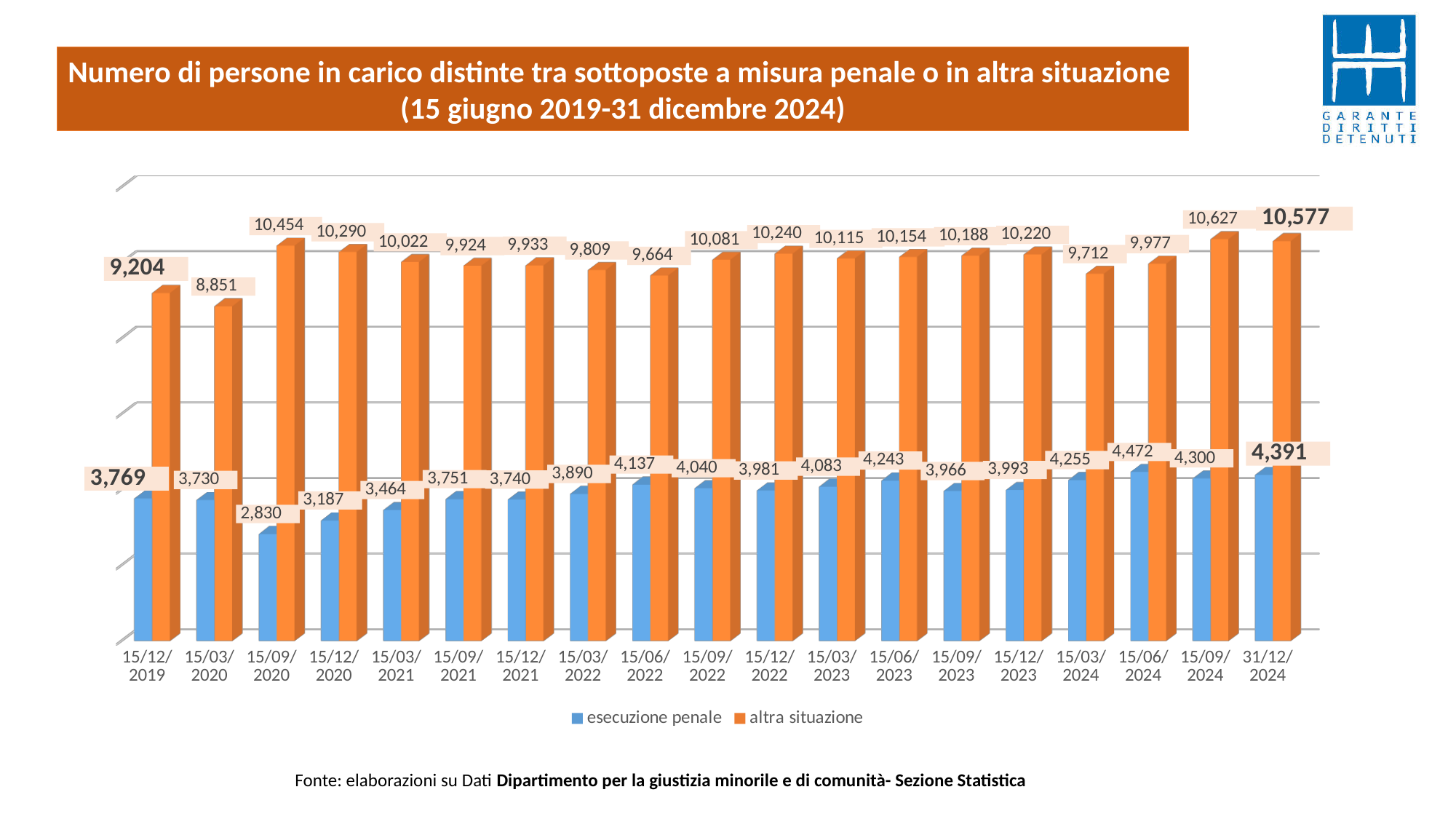
Which is larger: 'esecuzione penale' on 15/06/2024 or on 31/12/2024? 15/06/2024 What is the difference between the 'altra situazione' values on 15/09/2024 and 31/12/2024? 50 What is the value of 'esecuzione penale' on 15/12/2019? 3,769 Which colour represents 'altra situazione' in the chart? Orange On which date is the 'altra situazione' value highest? 15/09/2024 What is the value of 'altra situazione' on 15/09/2020? 10,454 What kind of chart is shown on the slide? Bar chart On which date is the 'altra situazione' value lowest? 15/03/2020 How many series does the legend list? 2 How many dates are shown on the x axis? 19 What is the value of 'altra situazione' on 31/12/2024? 10,577 On which date is the 'esecuzione penale' value lowest? 15/09/2020